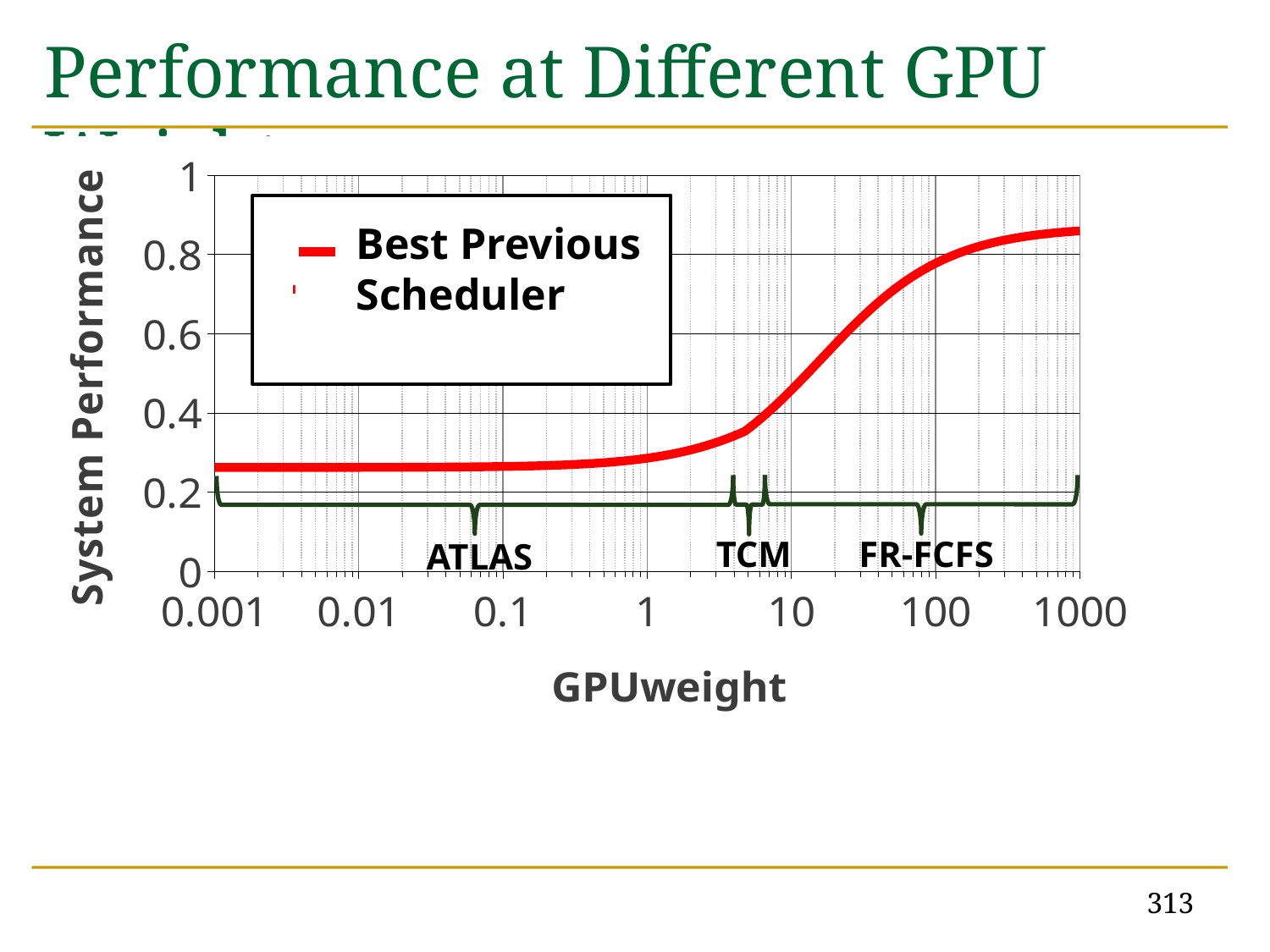
Is the System Performance value at GPUweight 10 greater or less than 0.4? greater Which has the higher System Performance: GPUweight 0.001 or GPUweight 1000? GPUweight 1000 Which has the lower System Performance: GPUweight 0.01 or GPUweight 100? GPUweight 0.01 Is the System Performance value at GPUweight 1000 greater or less than 0.8? greater At which end of the GPUweight axis does the curve reach its highest System Performance? 1000 What kind of chart is shown on the slide? line chart What is the label of the x axis? GPUweight What is the label of the y axis? System Performance Is the System Performance value at GPUweight 1 greater or less than 0.4? less Does the System Performance curve rise or fall as GPUweight increases from 0.001 to 1000? rise